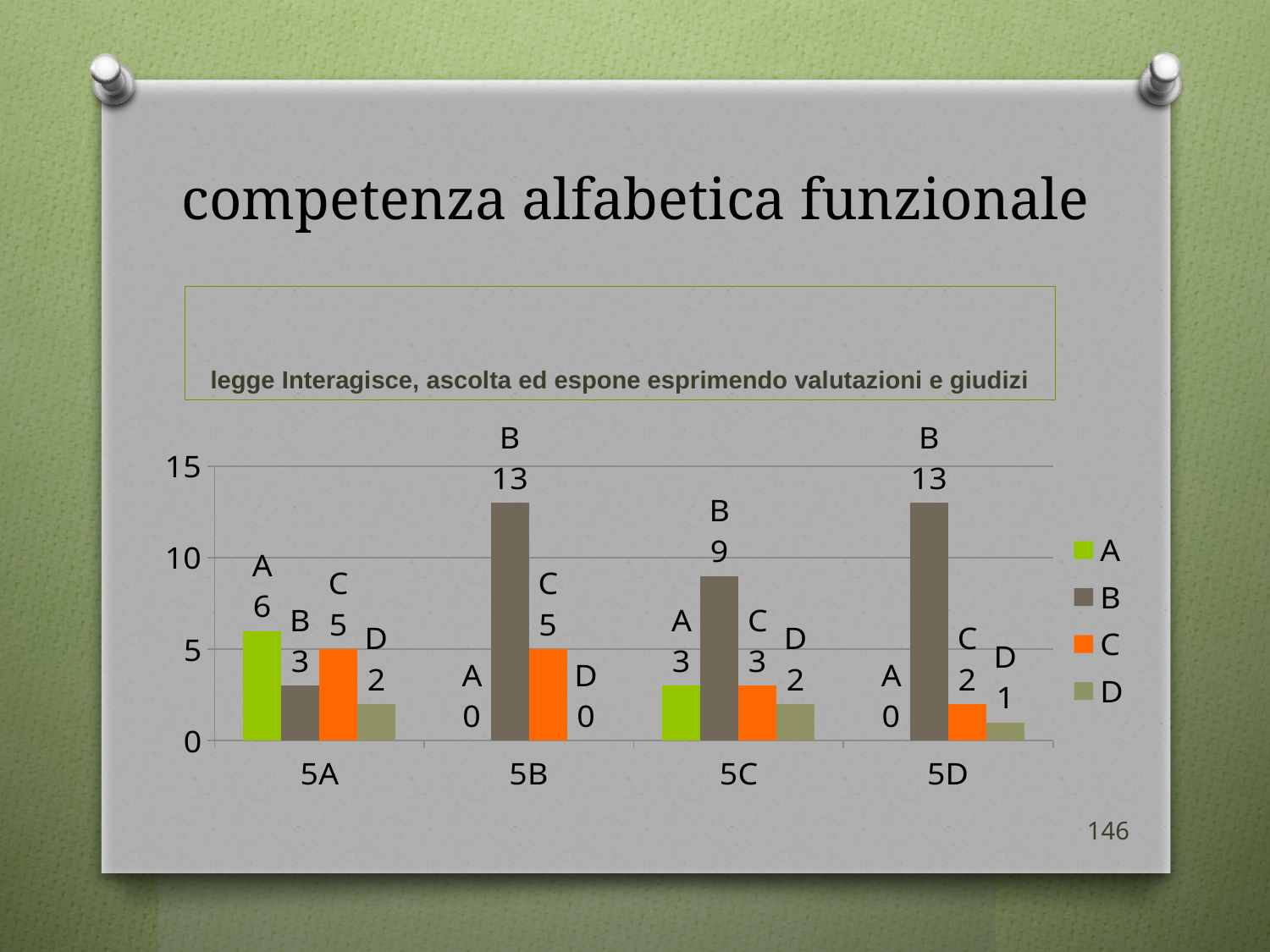
What is the value for series B in category 5B? 13 What is the value for series D in category 5D? 1 What is the total of the values for all four series in category 5C? 17 What is the value for series A in category 5D? 0 What is the value for series A in category 5A? 6 How many categories are shown on the x axis? 4 Which series has the lowest value in category 5A? D Which series has the highest value in category 5C? B How many series does the legend list? 4 Which is larger: the value for series A in 5A or the value for series A in 5C? 5A What is the difference between the values for series B and series C in category 5B? 8 What kind of chart is shown on the slide? bar chart